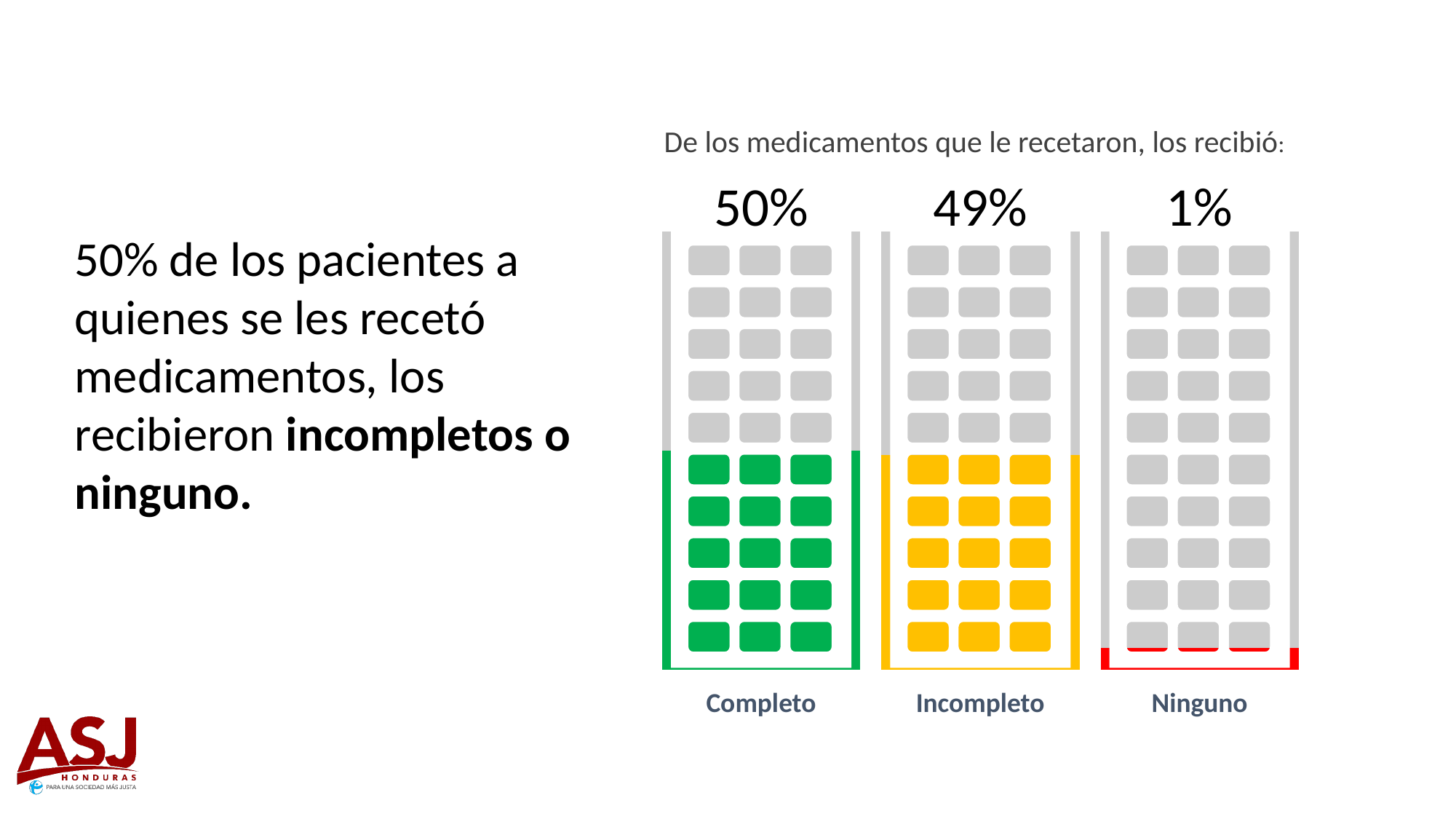
What is the value shown for Incompleto? 49% What is the difference between the values for Incompleto and Ninguno? 48 percentage points Which category has the lowest value? Ninguno Which is larger, the value for Incompleto or the value for Ninguno? Incompleto What is the title of the chart? De los medicamentos que le recetaron, los recibió: How many categories are shown in the chart? 3 What is the difference between the values for Completo and Incompleto? 1 percentage point What is the value shown for Ninguno? 1% What is the value shown for Completo? 50% What colour is used for the Completo category? Green Which category has the highest value? Completo What is the sum of the three percentages shown in the chart? 100%